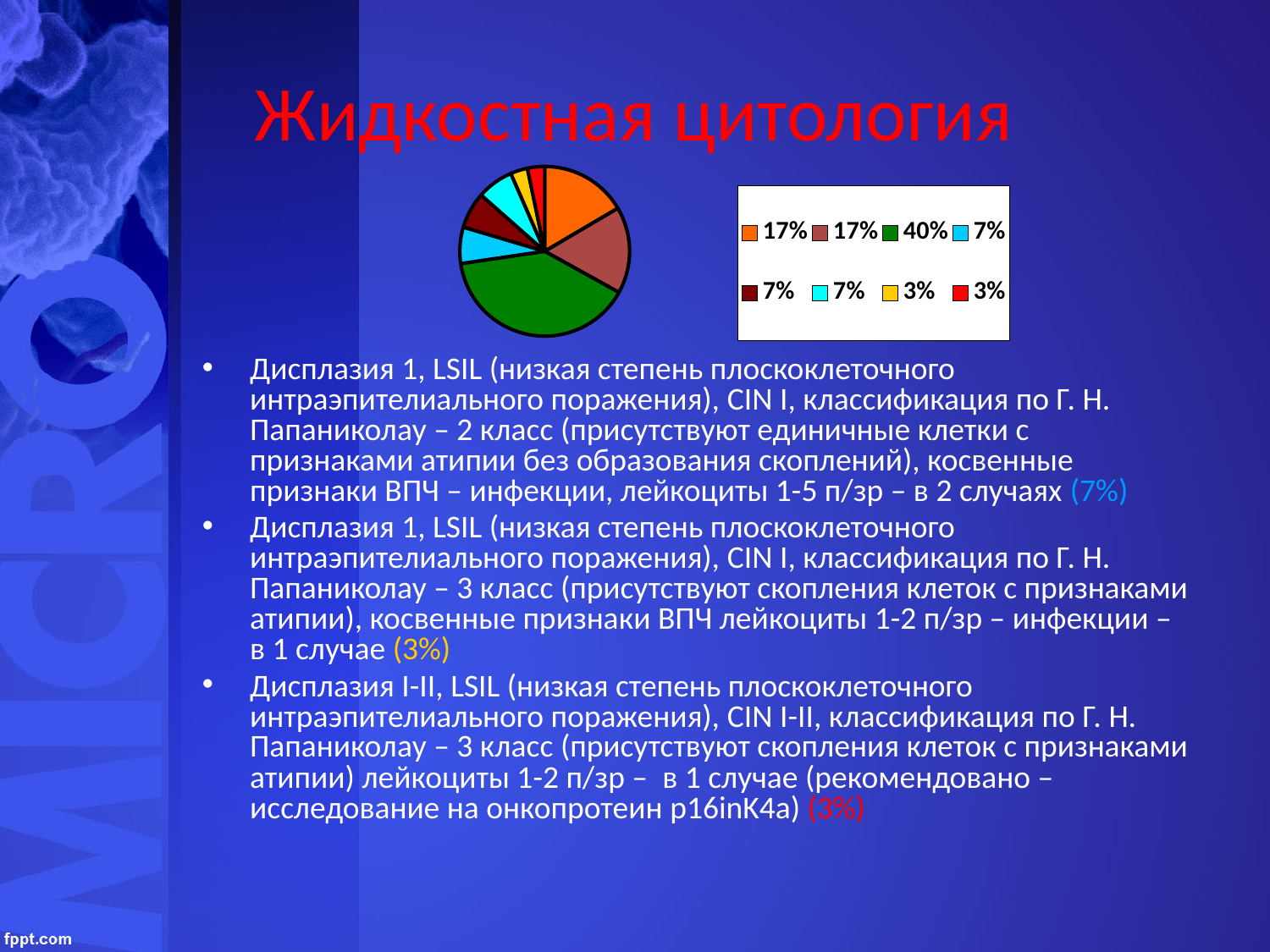
Which slice of the pie chart is the largest? the green slice (40%) What share of the pie does the red slice represent? 3% What kind of chart is shown on the slide? pie chart How many slices does the pie chart have? 8 What share of the pie does the green slice represent? 40% What is the combined share of the orange and brown slices? 34% What is the title of the slide containing the pie chart? Жидкостная цитология Which is larger in the pie chart, the green slice or the brown slice? the green slice How many entries does the legend of the pie chart list? 8 What is the difference between the green slice (40%) and the orange slice (17%)? 23% What share of the pie does the yellow slice represent? 3%